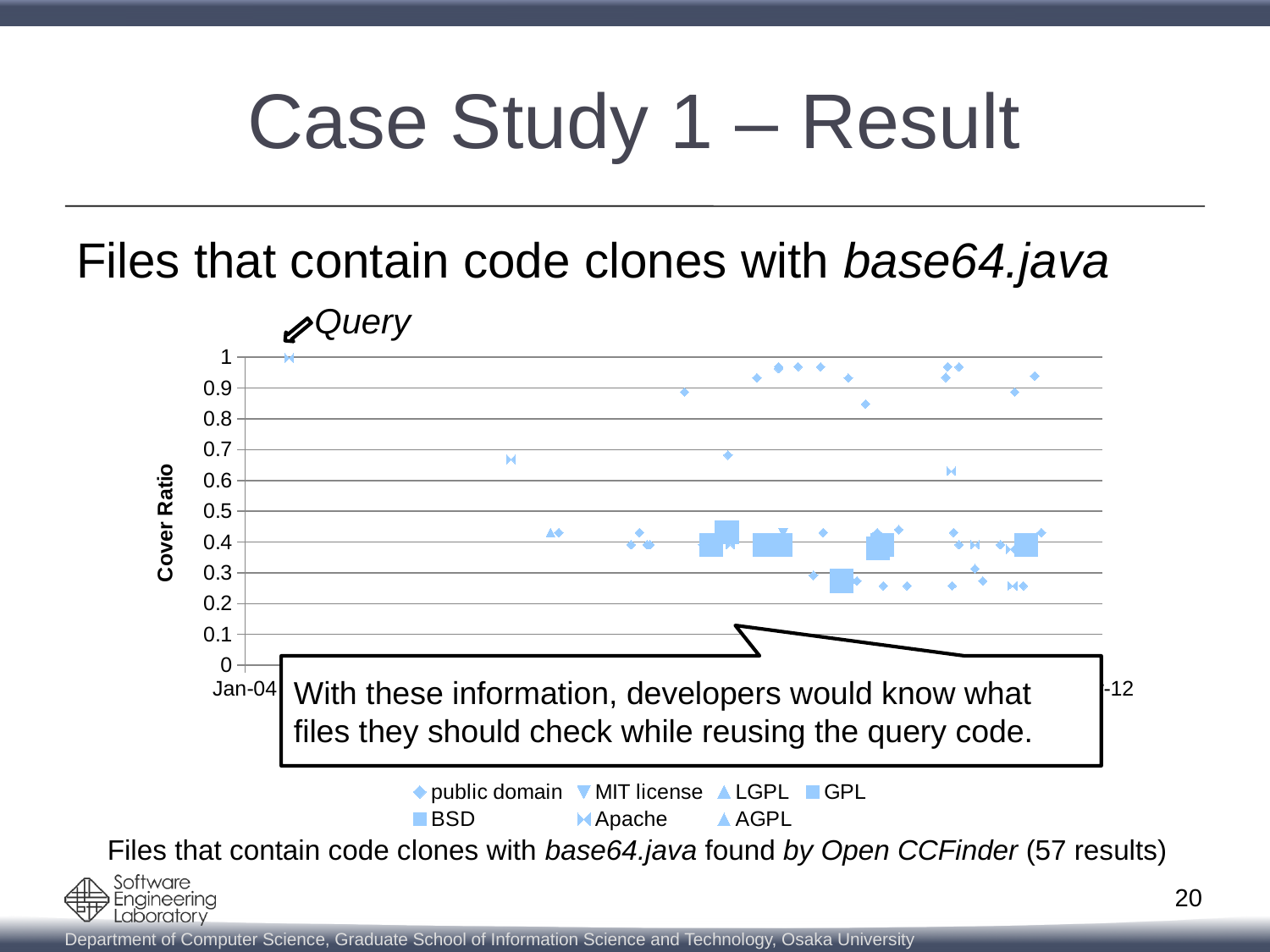
What kind of chart is shown on the slide? scatter chart How many series does the chart's legend list? 7 What is the label of the chart's vertical axis? Cover Ratio Is the Cover Ratio of the point marked 'Query' greater or less than 0.9? greater Is the Cover Ratio of the highest plotted points (other than the Query point) greater or less than 0.9? greater Is the Cover Ratio of the lowest plotted points greater or less than 0.2? greater What is the first date label shown on the chart's horizontal axis? Jan-04 What is the highest value shown on the chart's vertical axis? 1